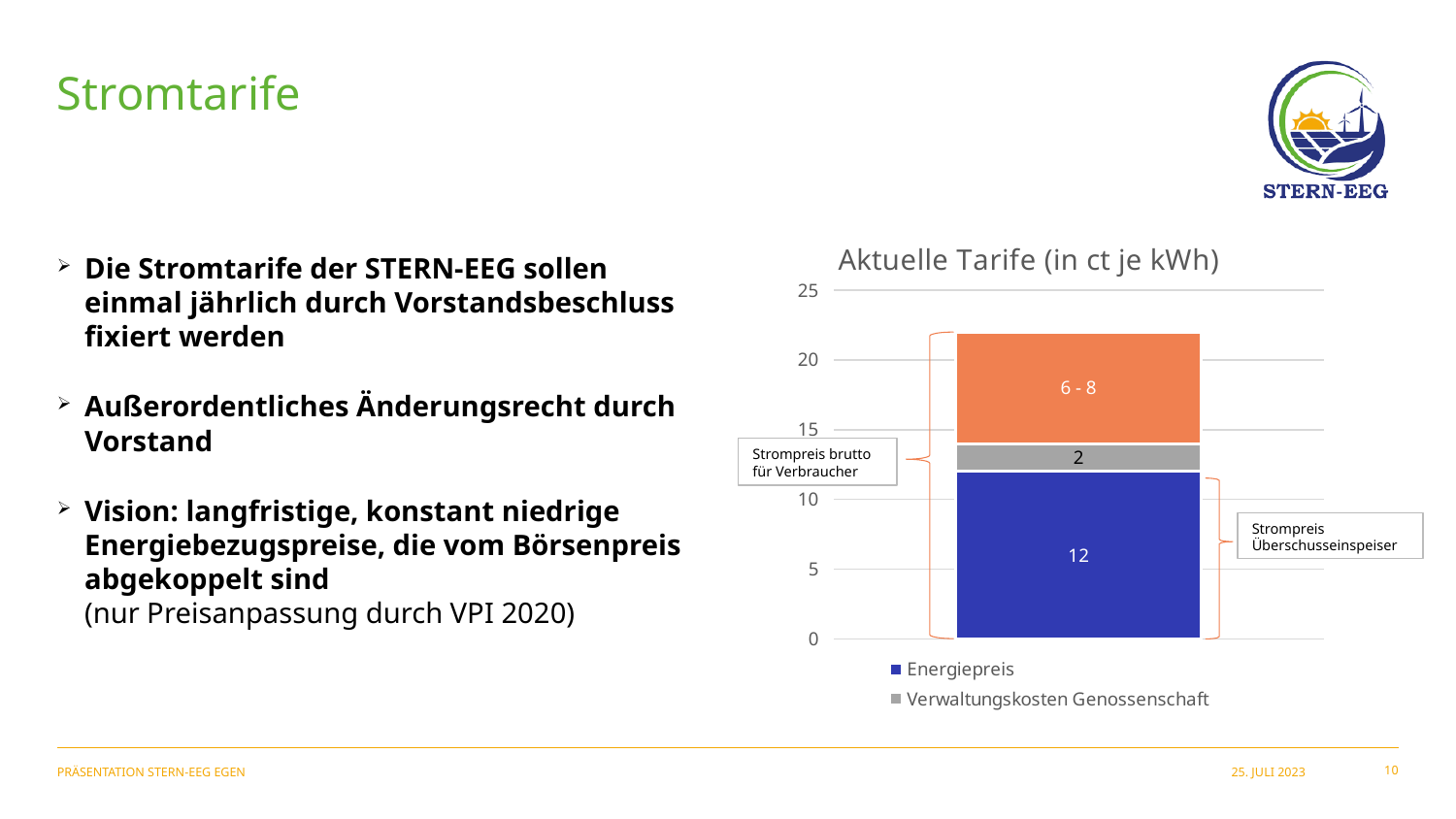
Which segment of the bar is the smallest? Verwaltungskosten Genossenschaft What kind of chart is shown on the slide? bar chart Which segment of the bar is the largest? Energiepreis How many stacked bars are plotted in the chart? 1 What is the title of the chart? Aktuelle Tarife (in ct je kWh) What label is printed on the top orange segment of the bar? 6 - 8 What is the value of the Verwaltungskosten Genossenschaft segment in the bar? 2 What is the difference between the Energiepreis value and the Verwaltungskosten Genossenschaft value? 10 Which is larger, Energiepreis or Verwaltungskosten Genossenschaft? Energiepreis Is the total height of the stacked bar greater or less than 20? greater What is the value of the Energiepreis segment in the bar? 12 How many series does the legend list? 2